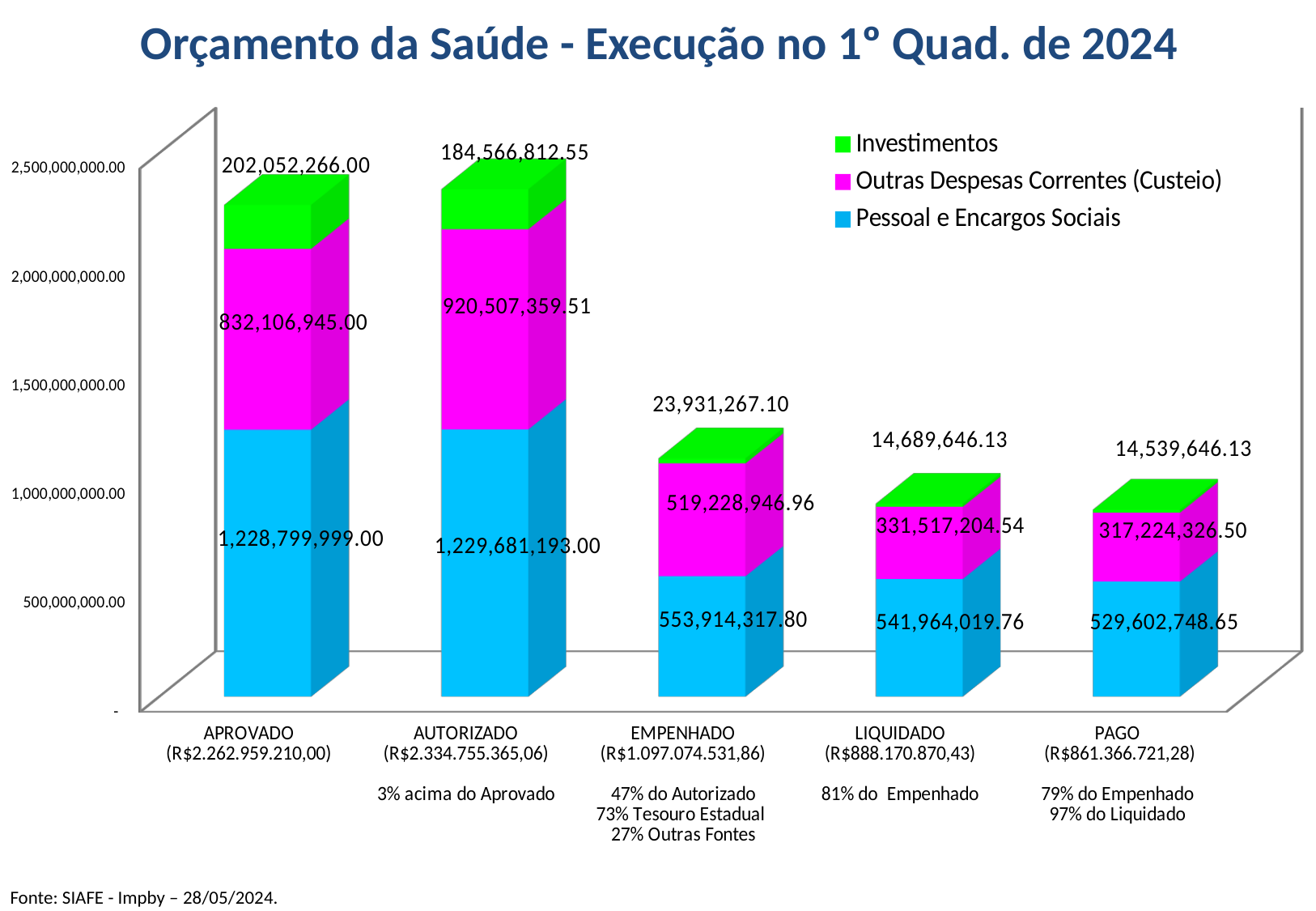
What is the total of the stacked bar for APROVADO? R$2.262.959.210,00 How many categories are shown on the x axis? 5 What is the value of Investimentos for EMPENHADO? 23,931,267.10 For EMPENHADO, which is larger: Pessoal e Encargos Sociais or Outras Despesas Correntes (Custeio)? Pessoal e Encargos Sociais What is the value of Pessoal e Encargos Sociais for APROVADO? 1,228,799,999.00 What is the difference between the Outras Despesas Correntes (Custeio) values for AUTORIZADO and APROVADO? 88,400,414.51 Which category has the highest value for Outras Despesas Correntes (Custeio)? AUTORIZADO Do the Investimentos values rise or fall from APROVADO to PAGO? fall What is the value of Outras Despesas Correntes (Custeio) for AUTORIZADO? 920,507,359.51 How many series does the legend list? 3 What is the value of Outras Despesas Correntes (Custeio) for PAGO? 317,224,326.50 Which category has the highest value for Investimentos? APROVADO